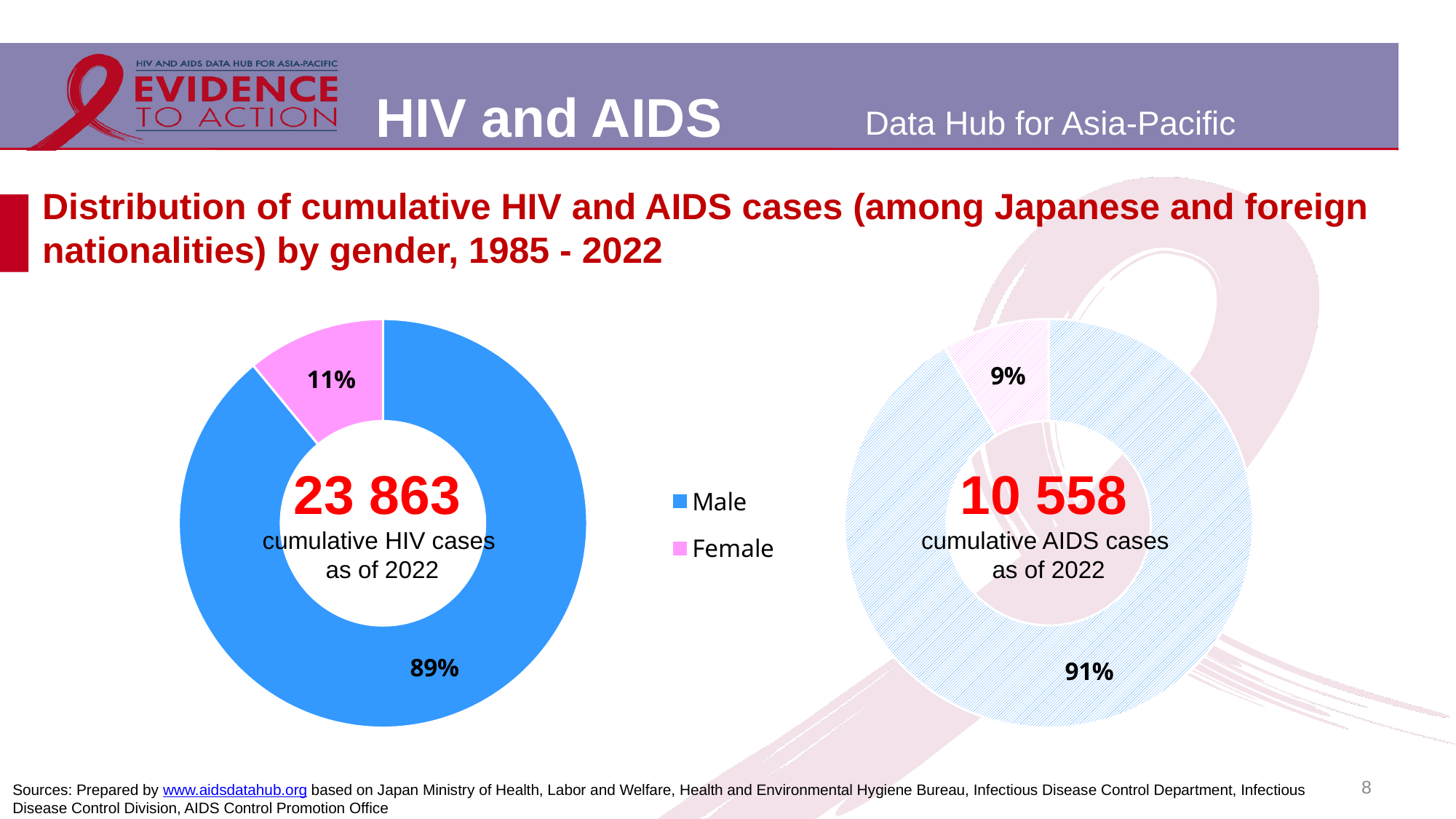
In the cumulative AIDS cases chart on the right, what share of cases is Female? 9% In the cumulative HIV cases chart on the left, what share of cases is Male? 89% What is the difference in percentage points between the Male and Female shares in the cumulative HIV cases chart on the left? 78 percentage points In the cumulative HIV cases chart on the left, which gender has the larger share? Male What type of chart is used to show the distribution of cumulative HIV cases on the left? Doughnut (pie) chart In the cumulative HIV cases chart on the left, what share of cases is Female? 11% In the cumulative AIDS cases chart on the right, which gender has the smaller share? Female What is the total number of cumulative AIDS cases as of 2022 shown in the centre of the right chart? 10 558 Is the Female share larger in the cumulative HIV cases chart on the left or in the cumulative AIDS cases chart on the right? Cumulative HIV cases chart (left) What is the total number of cumulative HIV cases as of 2022 shown in the centre of the left chart? 23 863 How many series does the legend list? 2